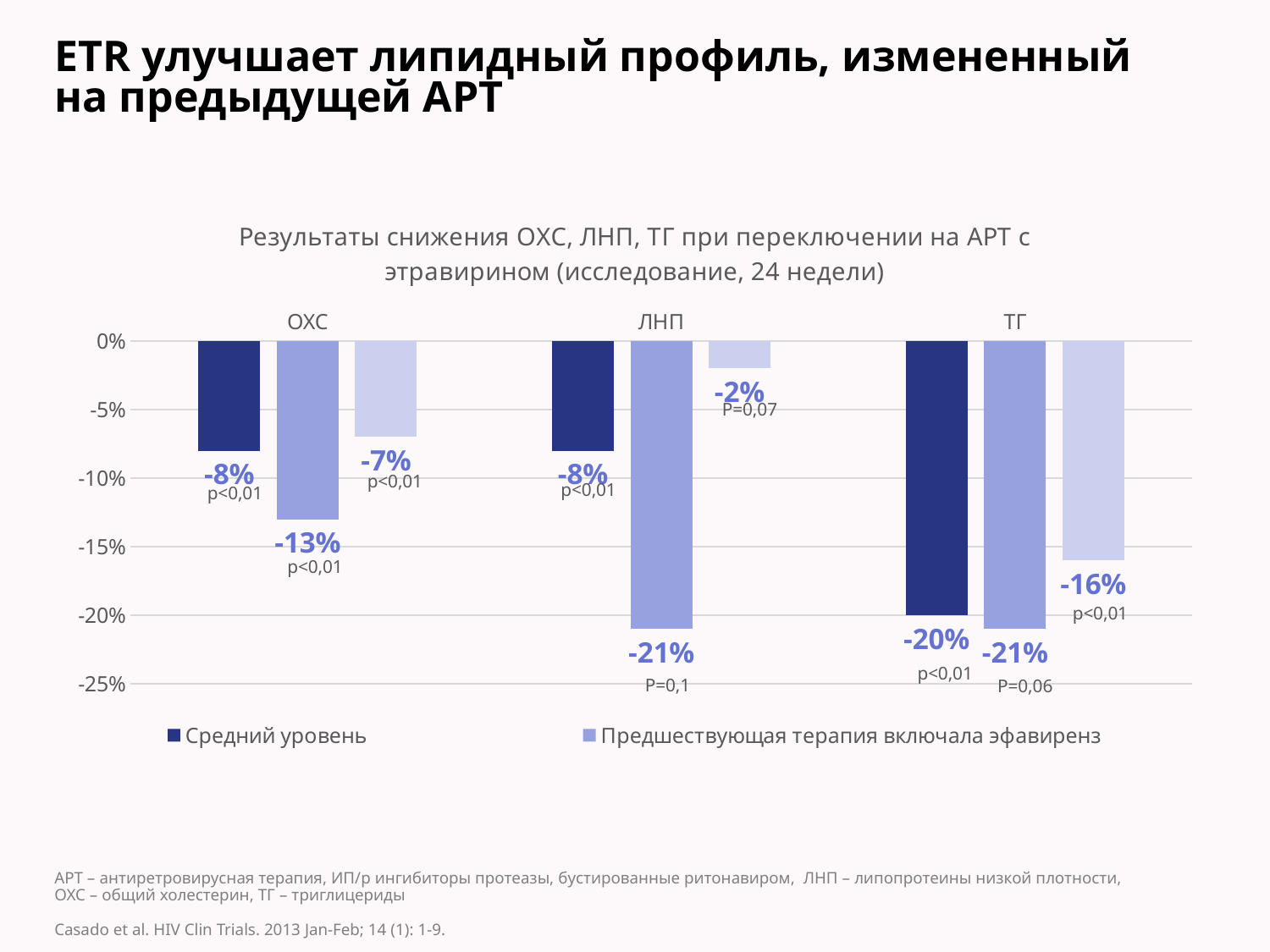
What kind of chart is shown on the slide? bar chart What is the value of Предшествующая терапия включала эфавиренз for ЛНП? -21% How many series does the chart legend list? 2 For the Средний уровень series, which category has the lowest value? ТГ What is the value shown by the lightest-coloured bar for ЛНП? -2% What is the value of Средний уровень for ОХС? -8% What is the difference between the Средний уровень and Предшествующая терапия включала эфавиренз values for ОХС? 5 percentage points What is the value of Средний уровень for ТГ? -20% What p-value is printed under the Предшествующая терапия включала эфавиренз bar for ЛНП? P=0,1 What is the value of Предшествующая терапия включала эфавиренз for ОХС? -13% How many categories are shown on the x axis of the chart? 3 For ЛНП, which series shows the larger reduction: Средний уровень or Предшествующая терапия включала эфавиренз? Предшествующая терапия включала эфавиренз